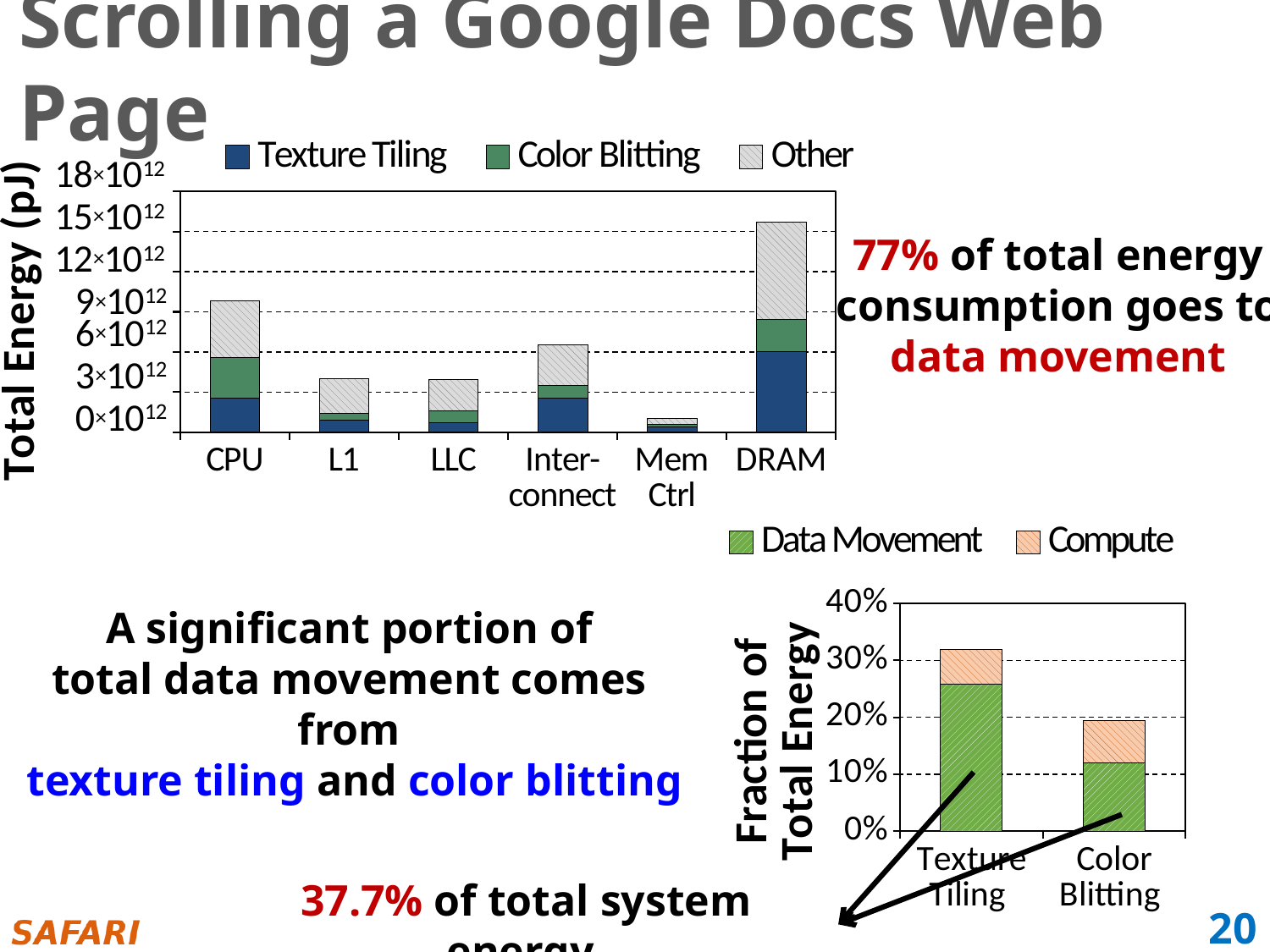
In the bottom Fraction of Total Energy chart, which category has the larger total bar, Texture Tiling or Color Blitting? Texture Tiling What are the two legend entries of the bottom Fraction of Total Energy chart? Data Movement and Compute In the top Total Energy chart, which category has the highest total energy? DRAM In the bottom Fraction of Total Energy chart, is the total for Color Blitting greater or less than 30%? less What kind of chart is the top chart showing Total Energy (pJ)? stacked bar chart In the top Total Energy chart, which has a larger total energy, CPU or Interconnect? CPU In the top Total Energy chart, is the total energy for DRAM greater or less than 12×10^12 pJ? greater In the top Total Energy chart, is the total energy for L1 greater or less than 6×10^12 pJ? less How many series does the legend of the bottom Fraction of Total Energy chart list? 2 How many categories are shown on the x axis of the top Total Energy chart? 6 How many series does the legend of the top Total Energy chart list? 3 In the top Total Energy chart, which category has the lowest total energy? Mem Ctrl